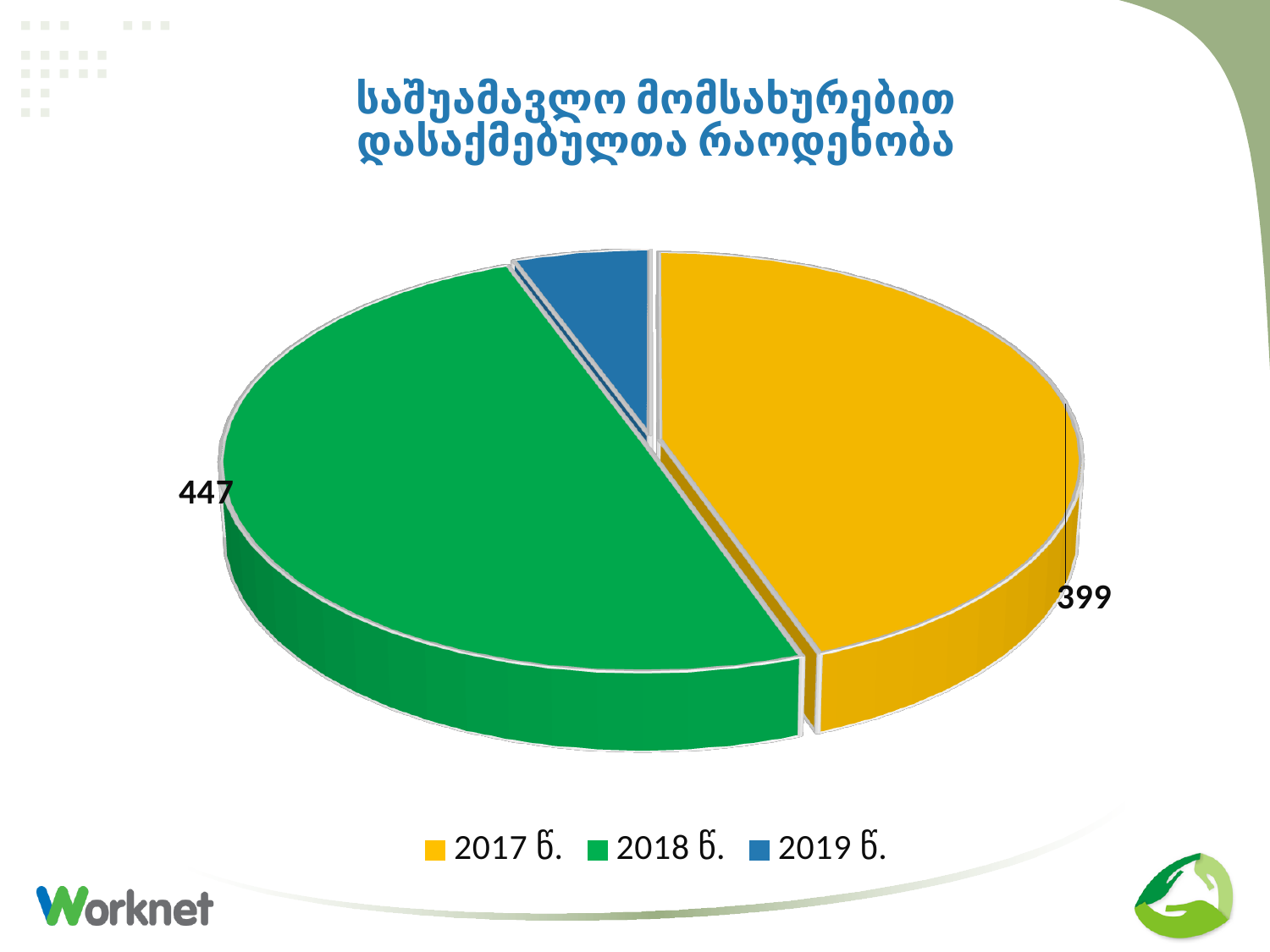
What is the value for 2018 წ. in the pie chart? 447 What is the title of the chart? საშუამავლო მომსახურებით დასაქმებულთა რაოდენობა Which year has the smallest slice in the pie chart? 2019 წ. How many slices does the pie chart have? 3 What is the value for 2017 წ. in the pie chart? 399 How many entries does the legend list? 3 Which year has the largest slice in the pie chart? 2018 წ. Which is larger, the value for 2017 წ. or the value for 2018 წ.? 2018 წ. What kind of chart is shown on the slide? Pie chart What colour is the slice for 2019 წ.? Blue What is the difference between the values for 2018 წ. and 2017 წ.? 48 Which slice is larger, 2017 წ. or 2019 წ.? 2017 წ.